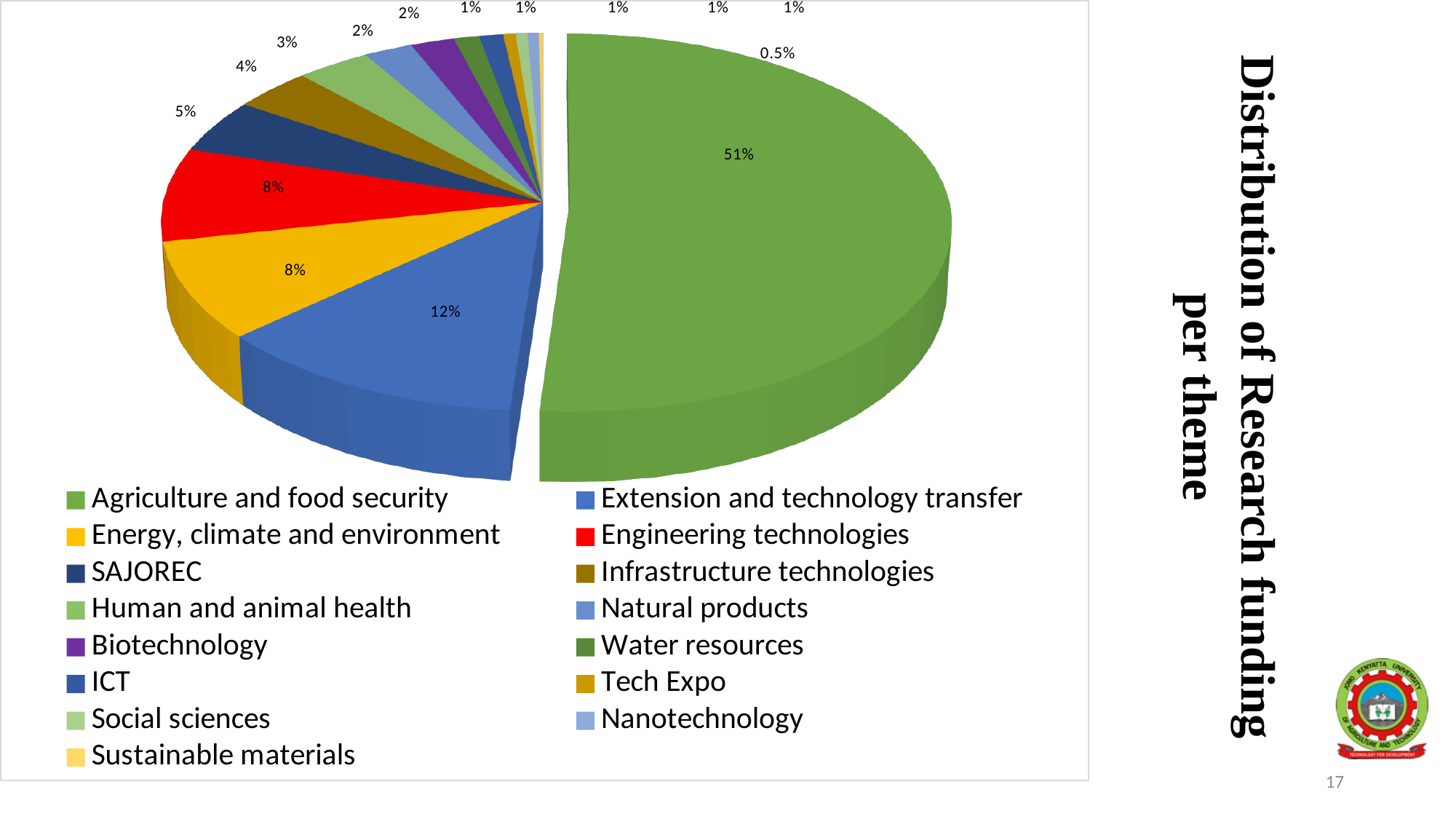
What share of funding does SAJOREC receive? 5% Which receives a larger share of funding, Extension and technology transfer or Engineering technologies? Extension and technology transfer How many percentage points larger is the Agriculture and food security share than the Extension and technology transfer share? 39 percentage points Which theme receives the largest share of research funding? Agriculture and food security What percentage of research funding goes to Infrastructure technologies? 4% What share of funding is allocated to Human and animal health? 3% Which theme receives the smallest share of research funding? Sustainable materials What is the title of the slide? Distribution of Research funding per theme What share of research funding goes to Agriculture and food security? 51% What percentage of research funding is for Extension and technology transfer? 12% What type of chart is shown on the slide? Pie chart How many themes are listed in the chart legend? 15